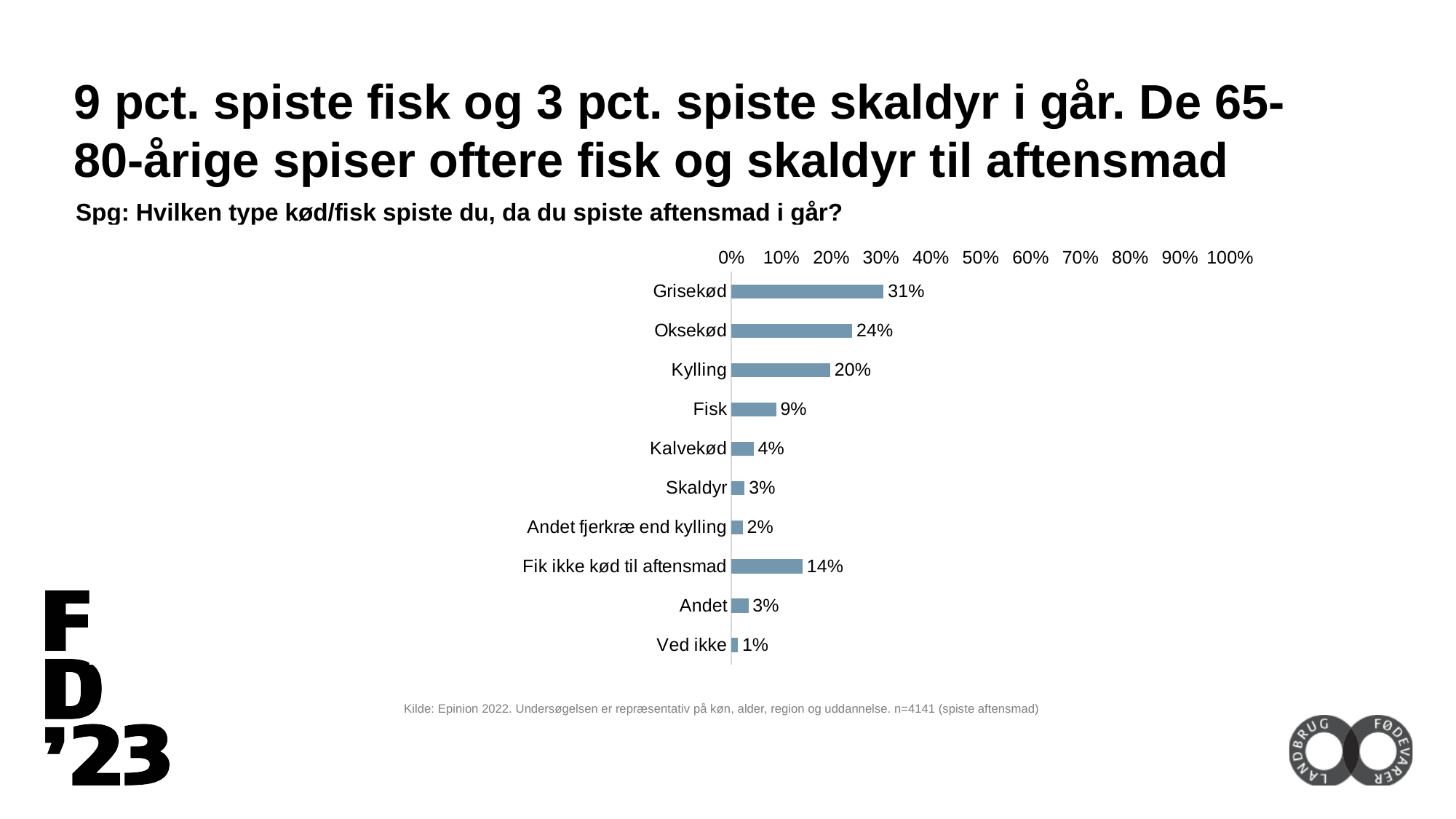
What percentage of respondents ate Grisekød for dinner yesterday? 31% Which is larger, the value for Oksekød or the value for Kylling? Oksekød What is the value shown for Fik ikke kød til aftensmad? 14% Which category has the highest value in the chart? Grisekød What is the difference between the values for Kylling and Fisk? 11% What is the value shown for Fisk? 9% What is the value shown for Skaldyr? 3% What kind of chart is shown on the slide? bar chart Which category has the lowest value in the chart? Ved ikke How many categories are shown in the chart? 10 Is the value for Grisekød greater or less than 40%? less What is the difference between the values for Grisekød and Oksekød? 7%